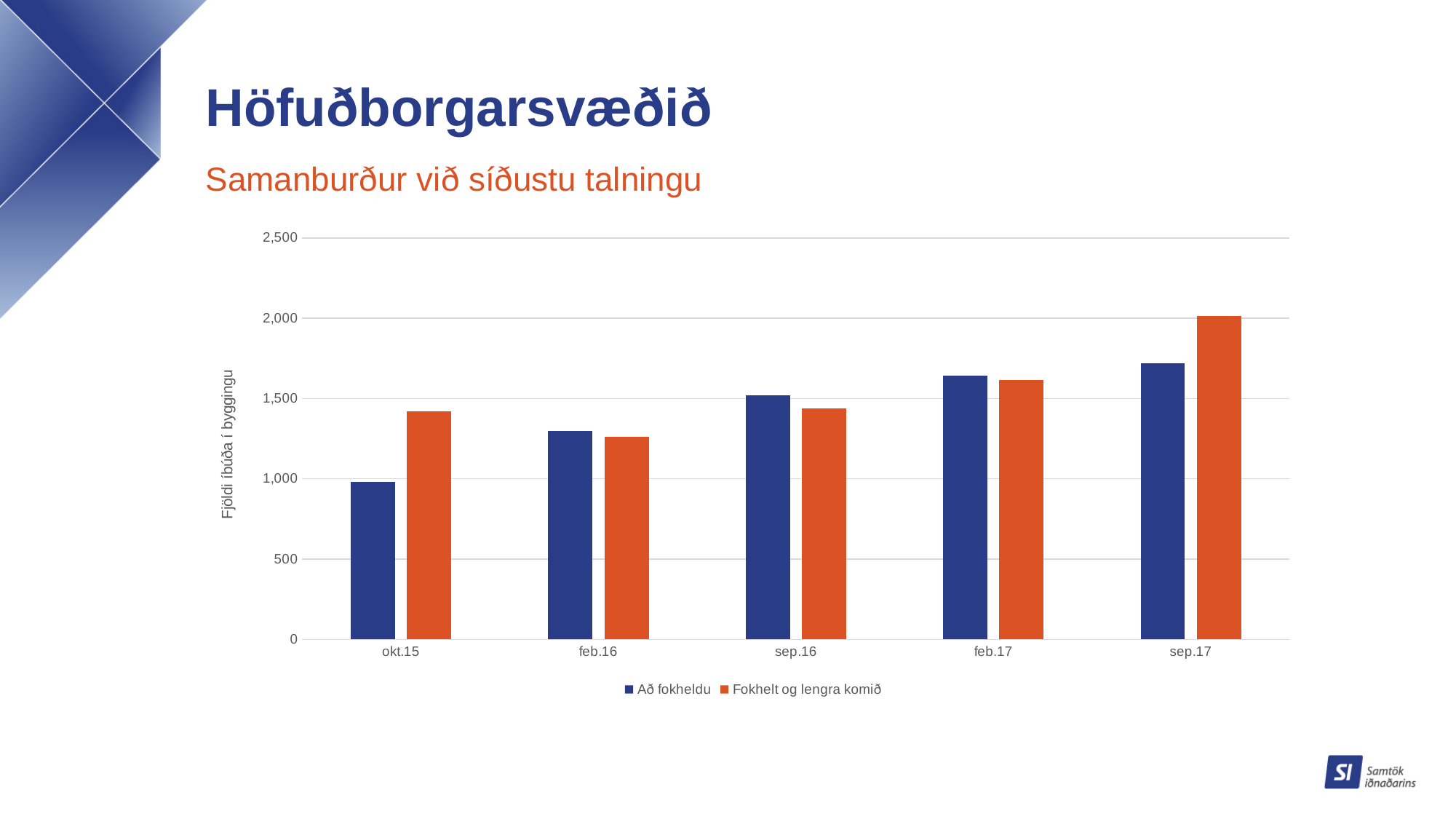
How many time periods are shown on the x axis? 5 How many series does the legend list? 2 Is the value for 'Að fokheldu' in sep.17 greater or less than 1,500? greater In which period is the value for 'Að fokheldu' lowest? okt.15 Do the values for 'Að fokheldu' rise or fall from okt.15 to sep.17? rise Is the value for 'Fokhelt og lengra komið' in okt.15 greater or less than 1,500? less In okt.15, which series has the larger value, 'Að fokheldu' or 'Fokhelt og lengra komið'? Fokhelt og lengra komið In which period is the value for 'Fokhelt og lengra komið' highest? sep.17 What kind of chart is shown on the slide? Bar chart In sep.17, which series has the larger value, 'Að fokheldu' or 'Fokhelt og lengra komið'? Fokhelt og lengra komið In which period is the value for 'Fokhelt og lengra komið' lowest? feb.16 What is the label on the vertical axis of the chart? Fjöldi íbúða í byggingu